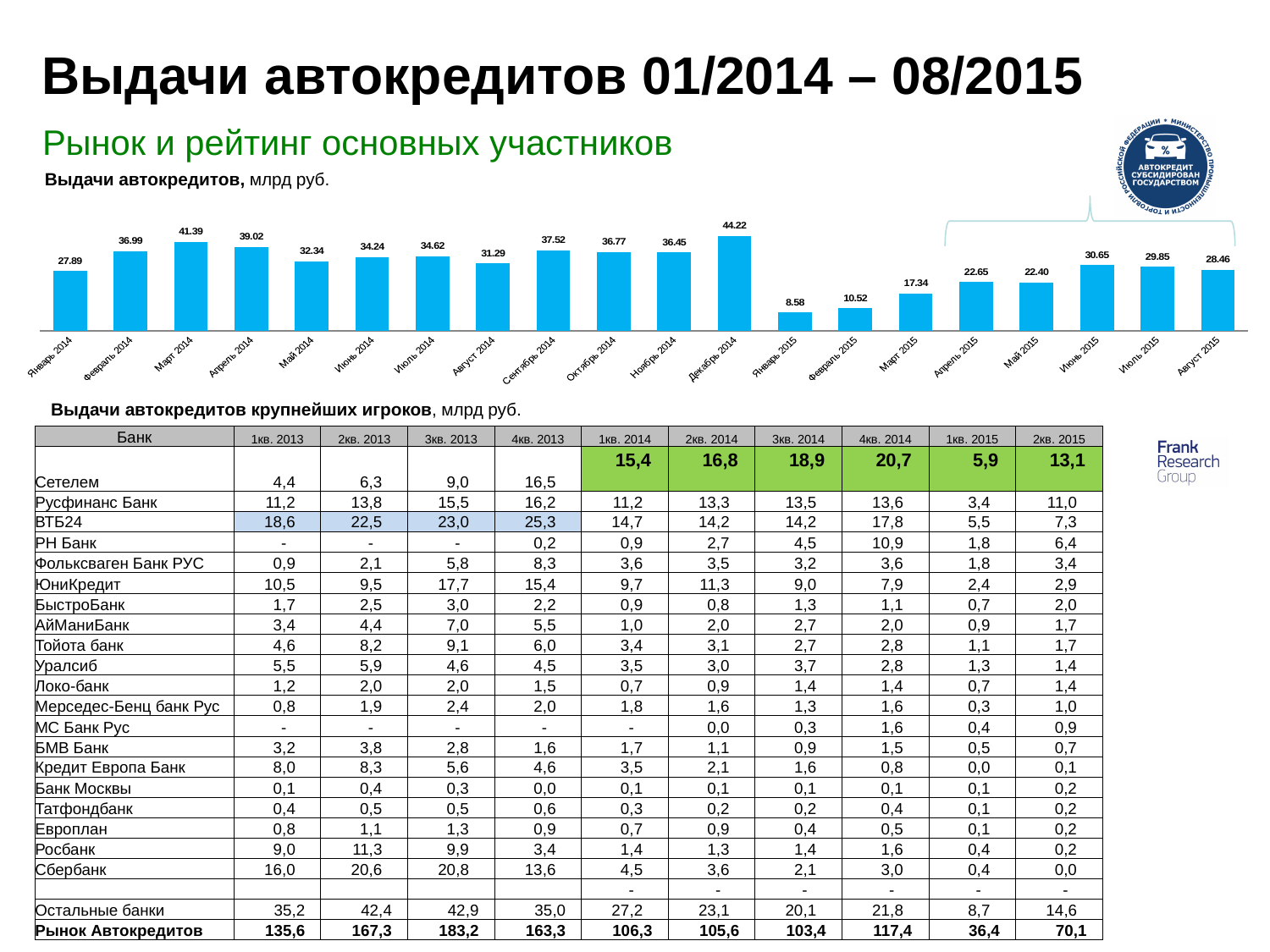
In the bar chart, what is the value for Август 2015? 28.46 What is the difference between the values for Декабрь 2014 and Январь 2015 in the bar chart? 35.64 In the bar chart, do the values rise or fall from Январь 2015 to Июнь 2015? rise What type of chart is used to show monthly car loan issuance (Выдачи автокредитов, млрд руб.)? bar chart In the bar chart, what is the value for Март 2014? 41.39 How many monthly bars are shown in the bar chart? 20 In the bar chart, which is larger: the value for Март 2014 or Апрель 2014? Март 2014 Which month has the lowest value in the bar chart? Январь 2015 What unit is stated in the bar chart's title (Выдачи автокредитов)? млрд руб. In the bar chart, what is the value for Декабрь 2014? 44.22 In the bar chart, what is the value for Январь 2015? 8.58 Which month has the highest value in the bar chart? Декабрь 2014